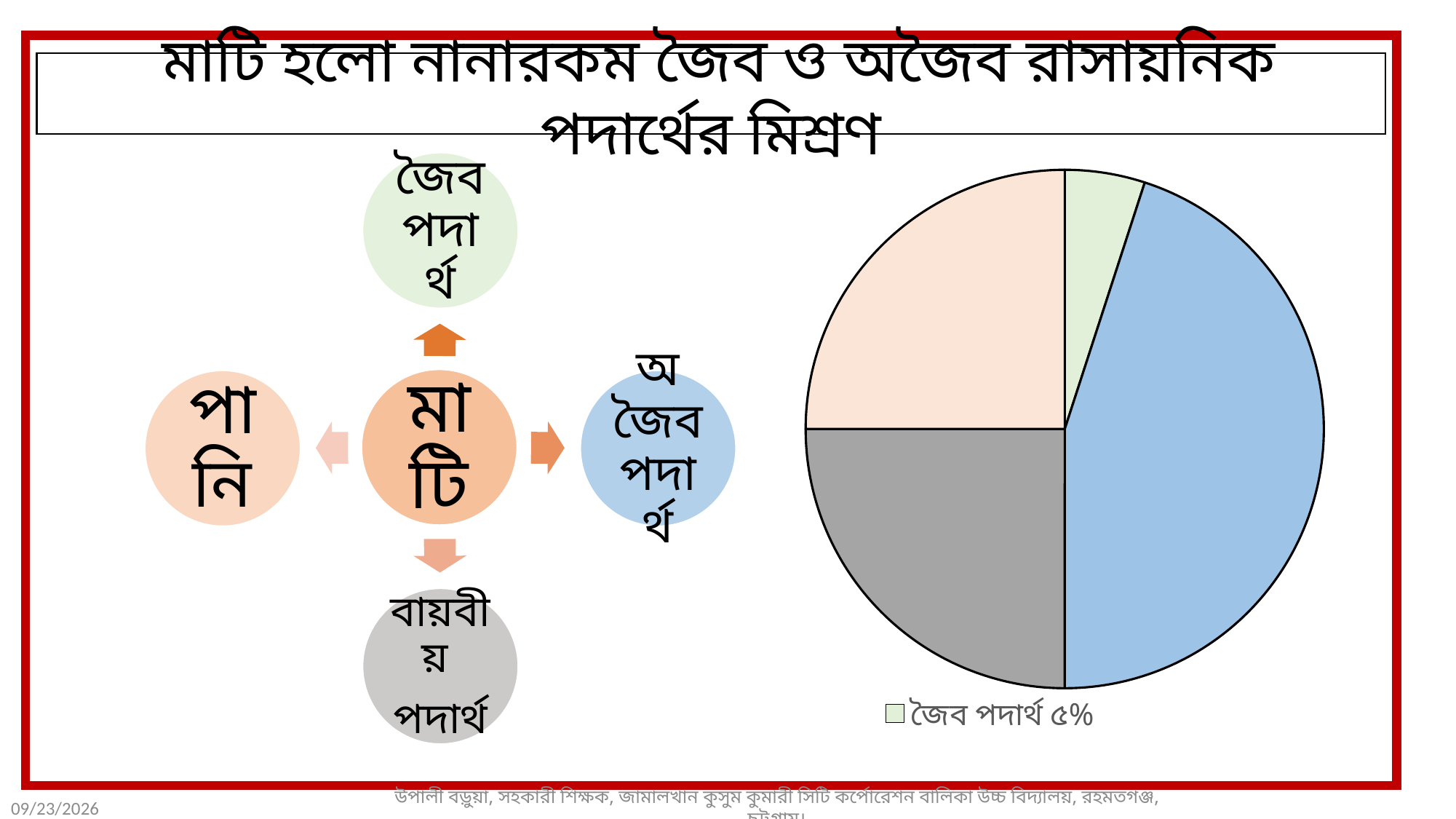
What colour is the জৈব পদার্থ slice in the pie chart? light green Is the blue slice of the pie chart larger or smaller than the grey slice? larger What share of the pie does জৈব পদার্থ represent, according to the legend? ৫% What text appears in the legend of the pie chart? জৈব পদার্থ ৫% Which colour slice of the pie chart is the largest? blue Which slice of the pie chart is the smallest? জৈব পদার্থ (the green slice) How many slices does the pie chart have? 4 Is the green slice of the pie chart larger or smaller than the peach slice? smaller How many entries does the pie chart's legend list? 1 What kind of chart is shown on the right side of the slide? pie chart